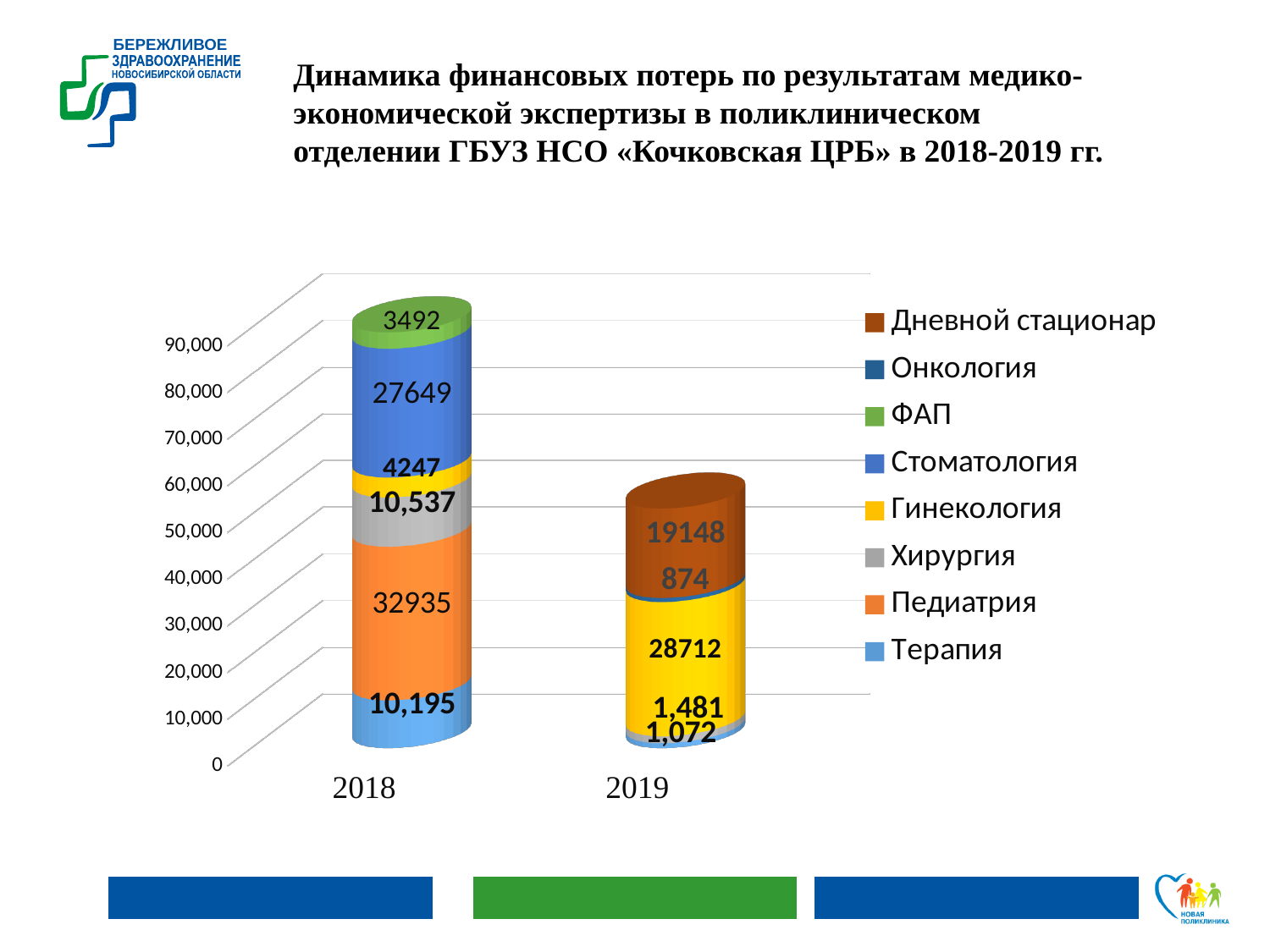
What is the difference between the 2018 values for Педиатрия and Стоматология? 5286 What is the value for Дневной стационар in 2019? 19148 What is the value for ФАП in 2018? 3492 What is the value for Стоматология in 2018? 27649 How many years (categories) are shown on the x axis? 2 What is the value for Гинекология in 2019? 28712 What is the value for Педиатрия in 2018? 32935 What kind of chart is shown on the slide? Stacked bar chart What is the value for Онкология in 2019? 874 How many series does the legend list? 8 Which year has the larger value for Гинекология, 2018 or 2019? 2019 Is the total height of the 2019 stacked bar greater or less than 60,000? less